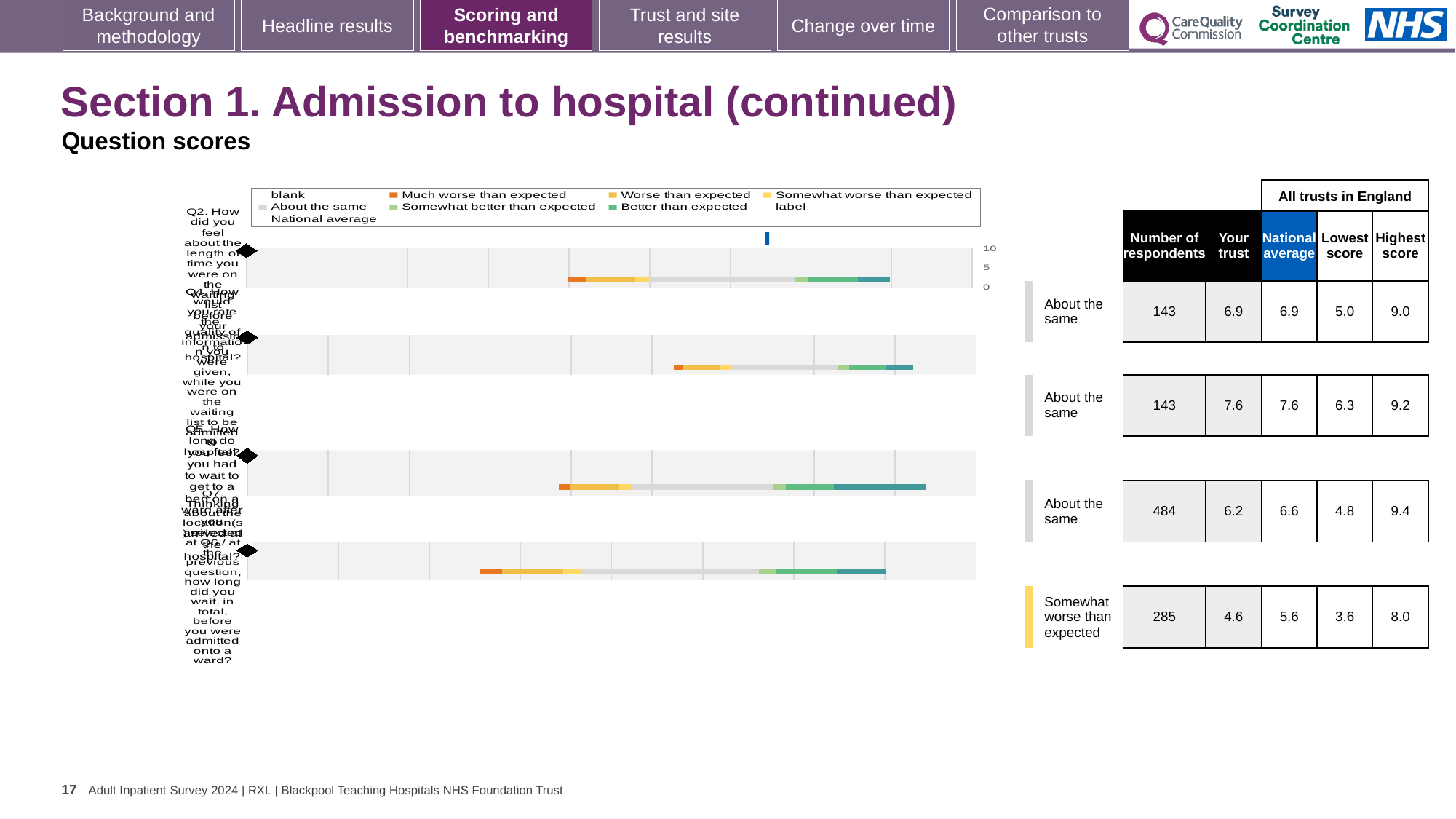
How many horizontal bars are plotted in the chart? 4 What is the maximum value shown on the chart's axis? 10 In the table beside the chart, what is the 'Your trust' score for the row with 484 respondents? 6.2 In the table beside the chart, what is the difference between the national average and the trust score for the row with 285 respondents? 1.0 What kind of chart is shown on the slide? bar chart In the table beside the chart, which row has the lowest 'Your trust' score? Somewhat worse than expected (285 respondents) What colour does the legend use for 'Much worse than expected'? orange In the table beside the chart, what is the 'Highest score' for the row rated 'Somewhat worse than expected'? 8.0